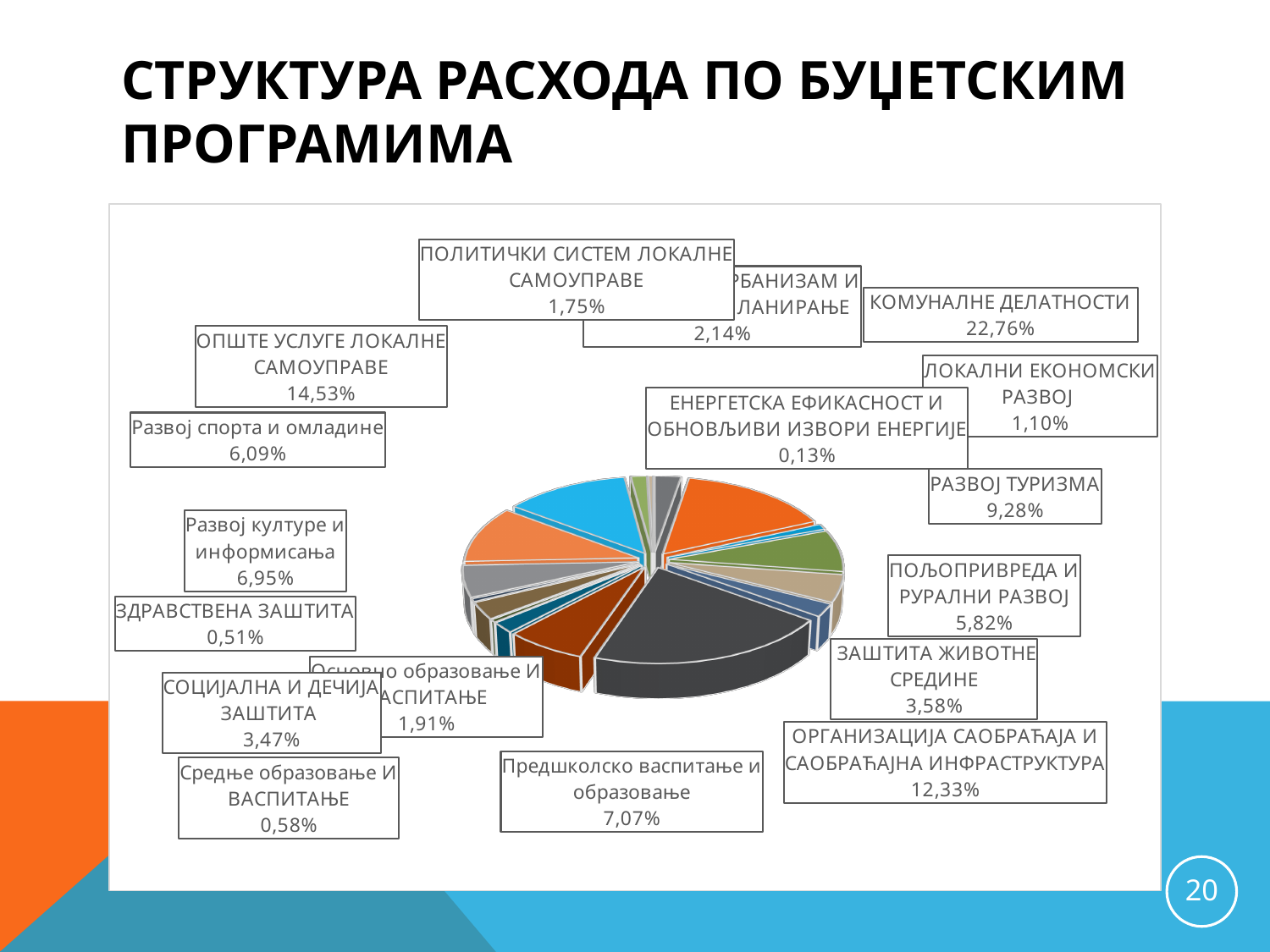
What share of expenditure goes to ОРГАНИЗАЦИЈА САОБРАЋАЈА И САОБРАЋАЈНА ИНФРАСТРУКТУРА? 12,33% What share of expenditure goes to РАЗВОЈ ТУРИЗМА? 9,28% What share of expenditure goes to КОМУНАЛНЕ ДЕЛАТНОСТИ? 22,76% What is the title of the slide? СТРУКТУРА РАСХОДА ПО БУЏЕТСКИМ ПРОГРАМИМА What is the difference in percentage points between КОМУНАЛНЕ ДЕЛАТНОСТИ and ОПШТЕ УСЛУГЕ ЛОКАЛНЕ САМОУПРАВЕ? 8,23 How many budget programmes (slices) are shown in the pie chart? 17 Which has a larger share: Развој спорта и омладине or Развој културе и информисања? Развој културе и информисања What kind of chart is shown on the slide? Pie chart What share of expenditure goes to Предшколско васпитање и образовање? 7,07% What share of expenditure goes to ОПШТЕ УСЛУГЕ ЛОКАЛНЕ САМОУПРАВЕ? 14,53% Which budget programme has the smallest share of expenditure? ЕНЕРГЕТСКА ЕФИКАСНОСТ И ОБНОВЉИВИ ИЗВОРИ ЕНЕРГИЈЕ Which budget programme has the largest share of expenditure? КОМУНАЛНЕ ДЕЛАТНОСТИ